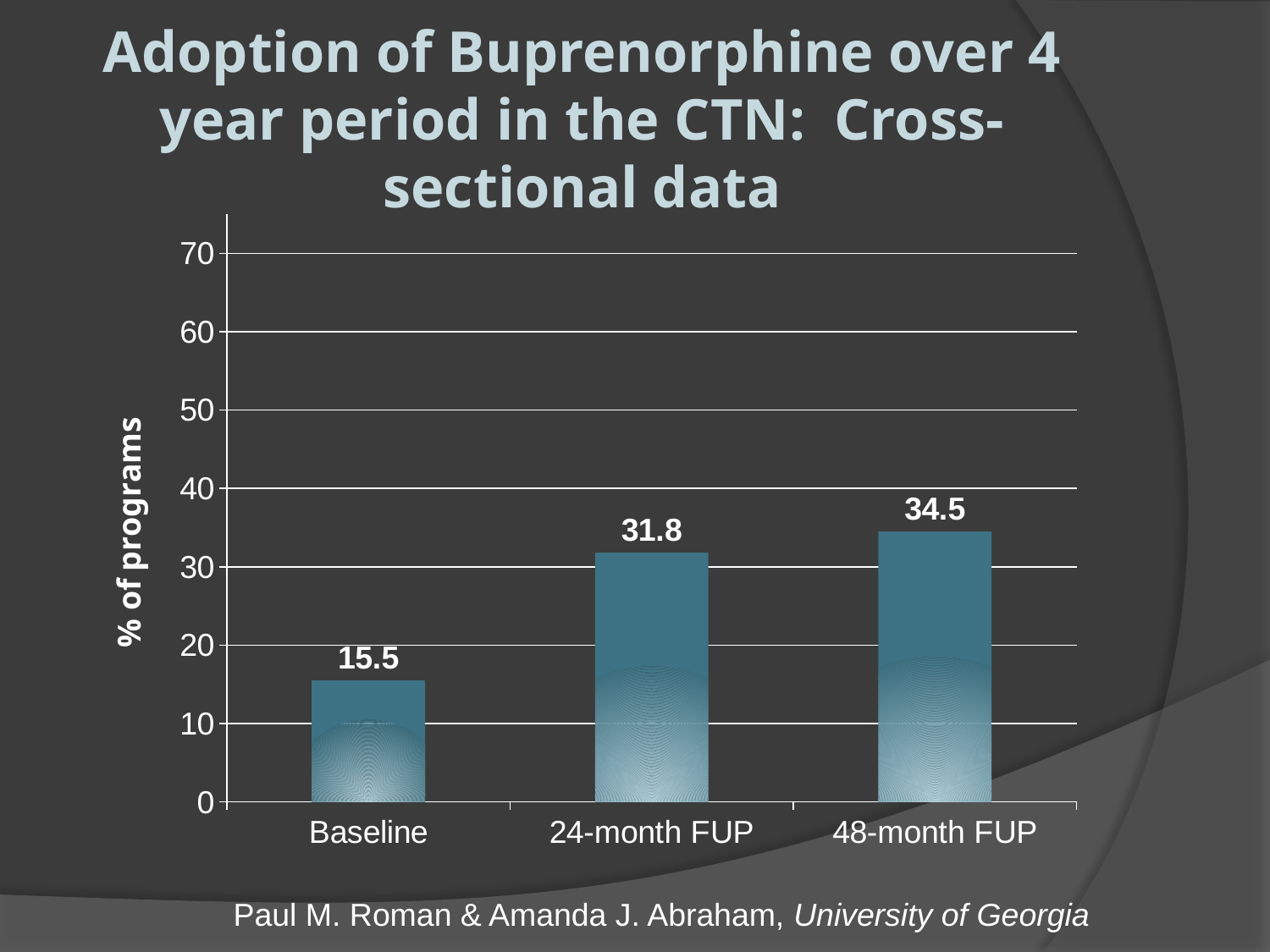
What is the difference between the 48-month FUP and Baseline values? 19.0 Which category has the highest value? 48-month FUP Which is larger, the value for 24-month FUP or the value for Baseline? 24-month FUP How many categories are shown on the x axis? 3 What is the value for 48-month FUP? 34.5 What is the value for 24-month FUP? 31.8 Do the values rise or fall from Baseline to 48-month FUP? rise Is the value for 48-month FUP greater or less than 30? greater What kind of chart is shown? bar chart What is the value for Baseline? 15.5 Which category has the lowest value? Baseline What is the difference between the 24-month FUP and Baseline values? 16.3